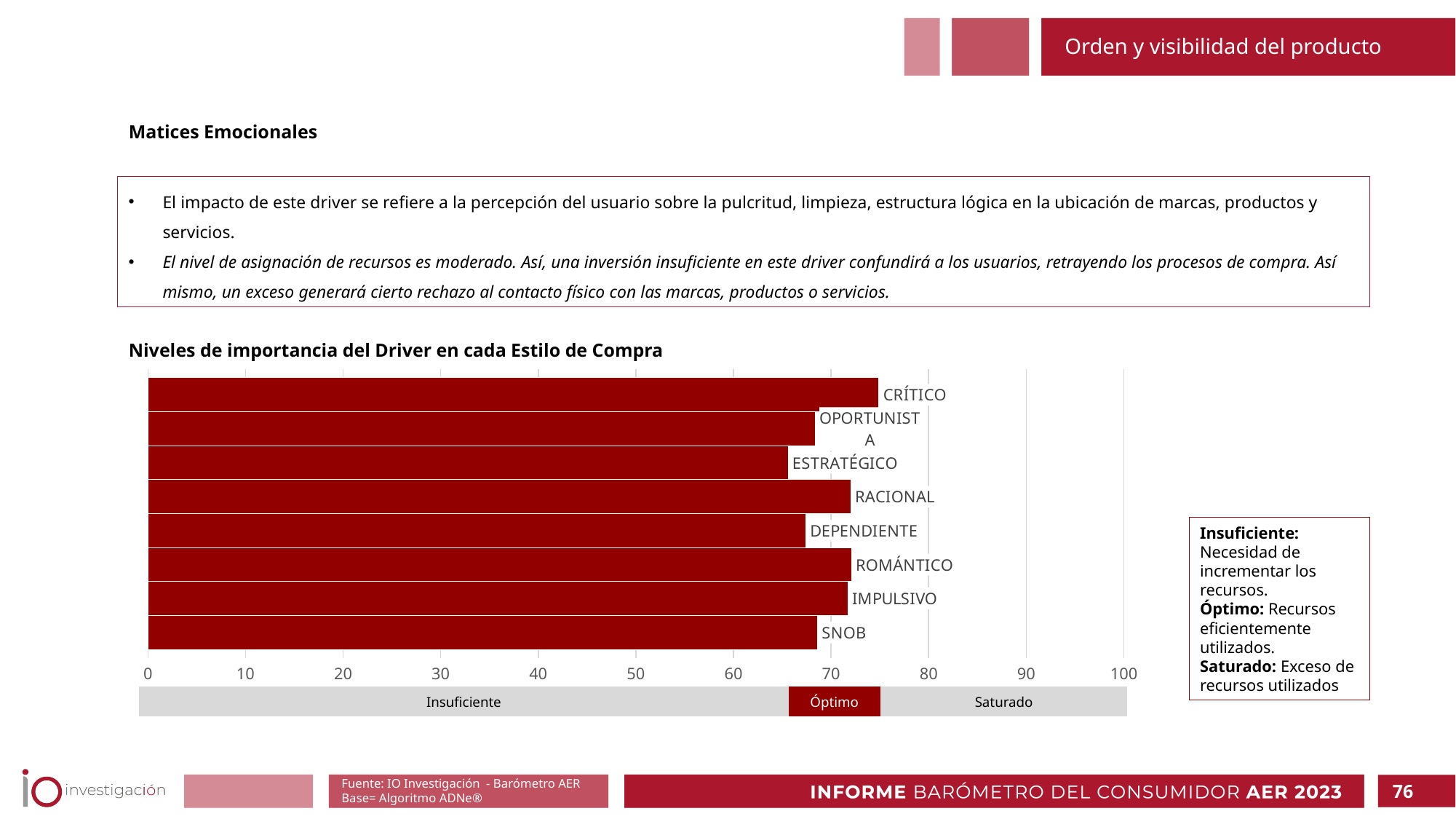
What kind of chart is shown under 'Niveles de importancia del Driver en cada Estilo de Compra'? Bar chart Which purchase style has the lowest value in the bar chart? ESTRATÉGICO Which has a larger value, ESTRATÉGICO or RACIONAL? RACIONAL Is the value for RACIONAL greater or less than 70? greater What is the maximum value shown on the horizontal axis of the bar chart? 100 Is the value for SNOB greater or less than 70? less Is the value for CRÍTICO greater or less than 70? greater What are the three zone labels shown in the band below the bar chart's axis? Insuficiente, Óptimo, Saturado Which has a larger value, CRÍTICO or SNOB? CRÍTICO Which purchase style has the highest value in the bar chart? CRÍTICO How many purchase styles (categories) are plotted in the bar chart? 8